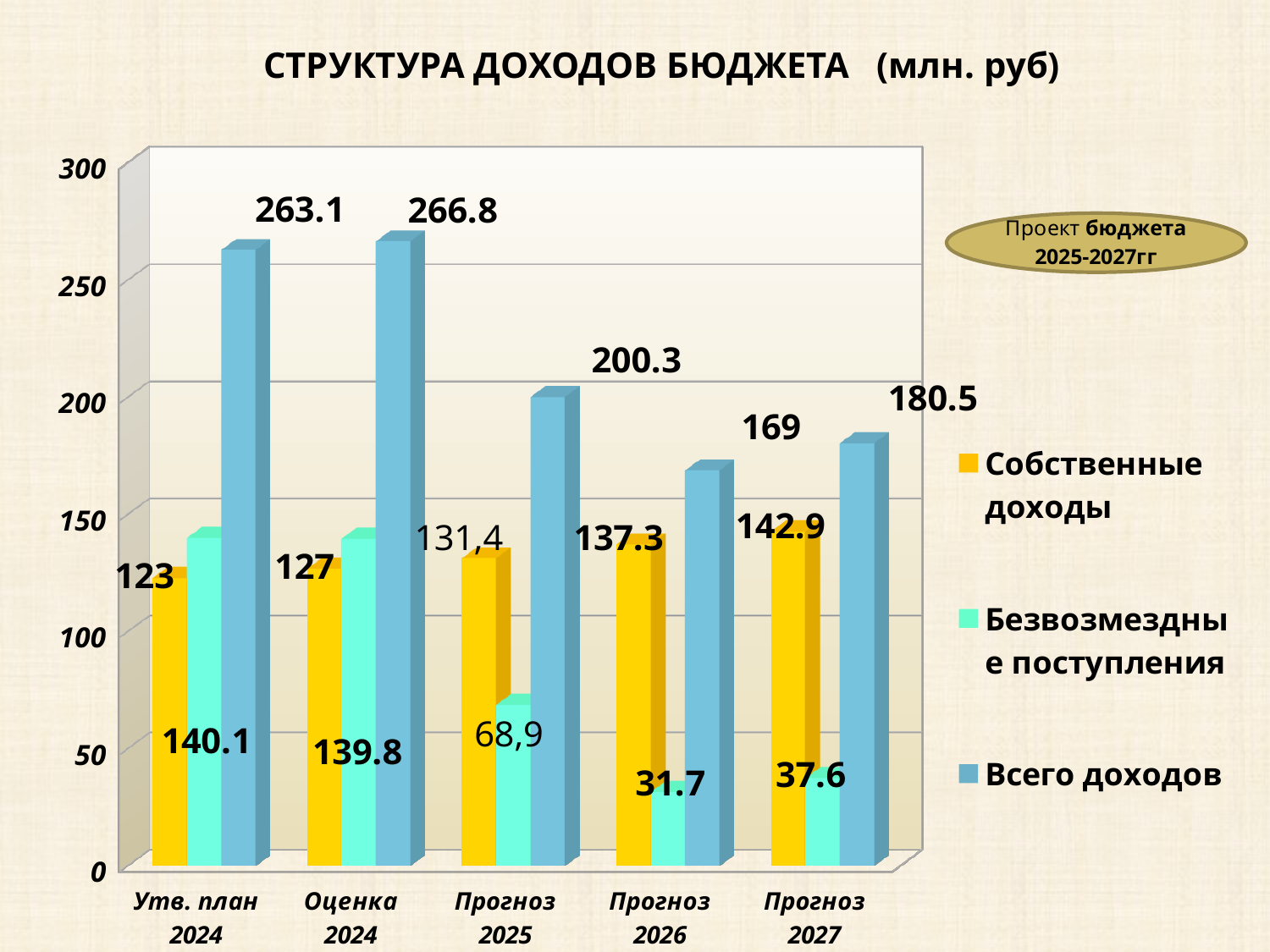
Do the values of Собственные доходы rise or fall from Утв. план 2024 to Прогноз 2027? rise What is the value of Безвозмездные поступления for Прогноз 2026? 31.7 What is the value of Безвозмездные поступления for Прогноз 2025? 68,9 Is the value of Всего доходов for Прогноз 2025 greater or less than 150? greater What is the value of Всего доходов for Оценка 2024? 266.8 How many series does the legend list? 3 What is the difference between Всего доходов for Оценка 2024 and Утв. план 2024? 3.7 How many categories are shown on the x axis? 5 Which category has the highest value of Всего доходов? Оценка 2024 Which is larger: Собственные доходы for Прогноз 2026 or Безвозмездные поступления for Прогноз 2026? Собственные доходы What is the value of Собственные доходы for Прогноз 2027? 142.9 Which category has the lowest value of Безвозмездные поступления? Прогноз 2026